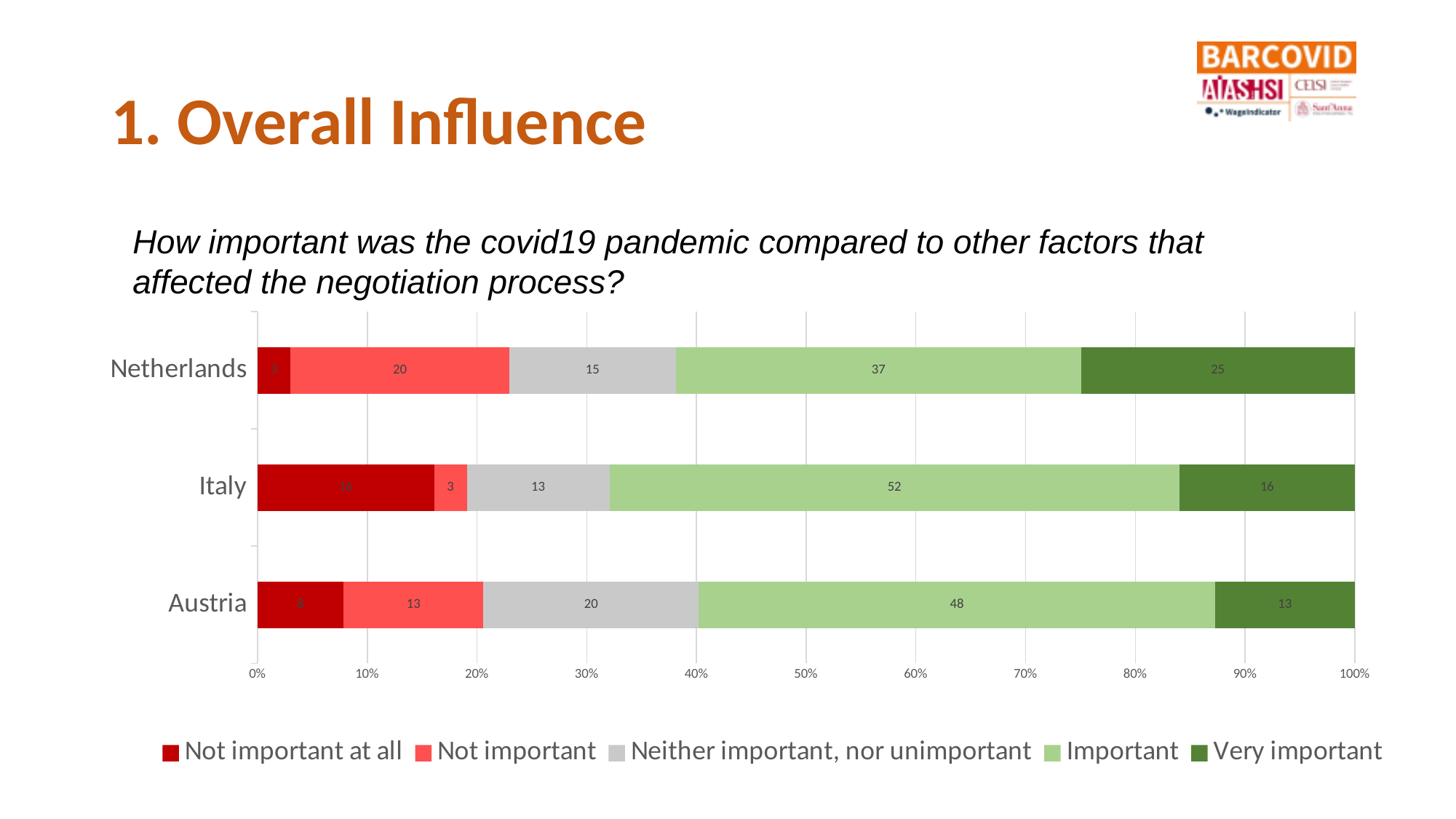
What is the value for "Very important" for the Netherlands? 25 What kind of chart is shown on the slide? Stacked bar chart Which country has the highest value for "Important"? Italy What is the value for "Not important" for Italy? 3 Which colour represents "Very important" in the legend? Dark green Which is larger: the "Not important" value for the Netherlands or for Austria? Netherlands What is the value for "Important" for Italy? 52 What is the difference between the "Important" values for Italy and Austria? 4 What is the value for "Neither important, nor unimportant" for Austria? 20 Which country has the lowest value for "Very important"? Austria How many countries are shown in the chart? 3 How many series does the legend list? 5